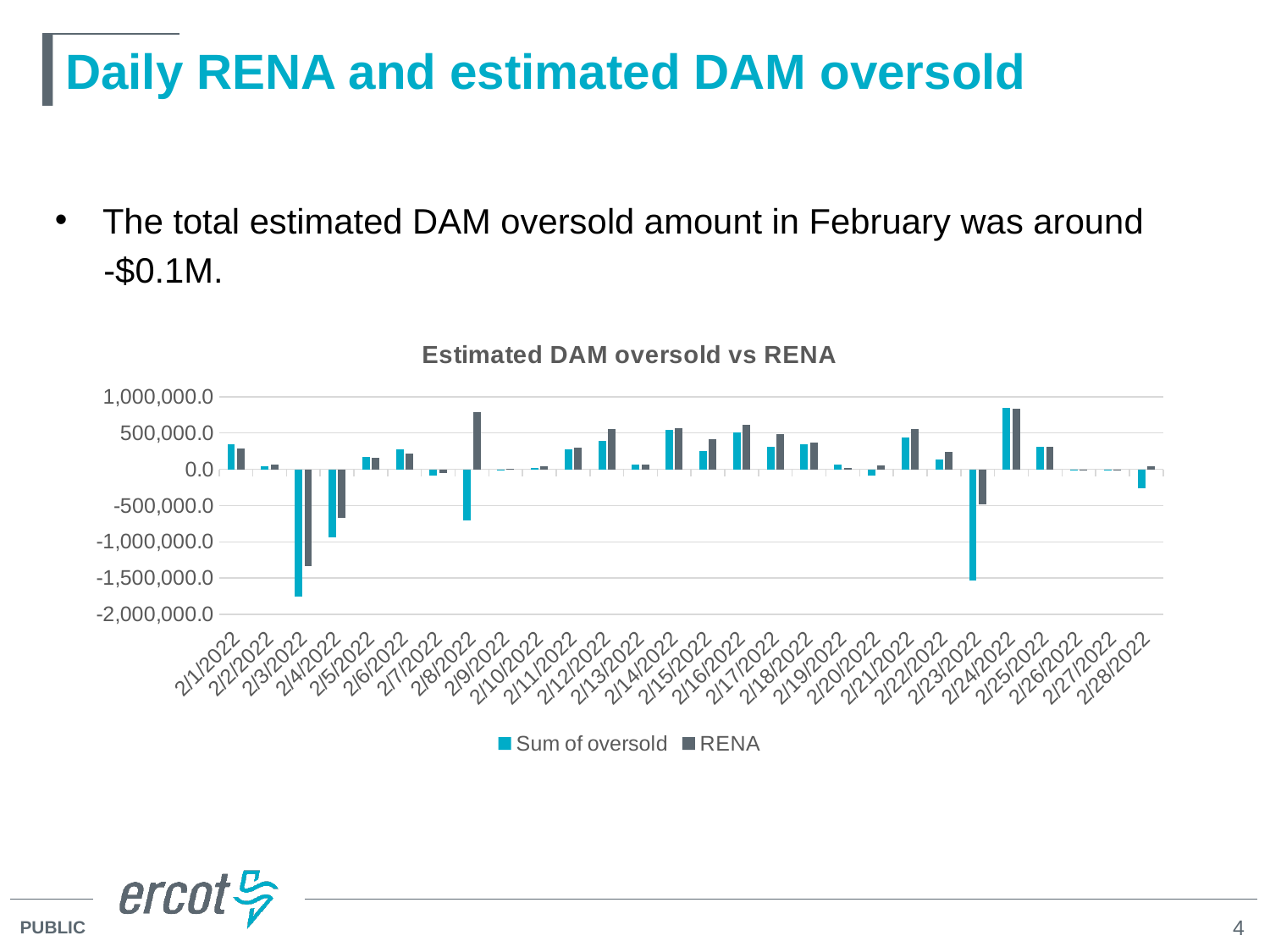
On 2/3/2022, which series has the larger value, Sum of oversold or RENA? RENA Is the RENA value for 2/8/2022 greater or less than 500,000.0? greater What are the two series named in the chart legend? Sum of oversold and RENA How many dates are shown on the x axis of the chart? 28 On which date is the Sum of oversold value the lowest? 2/3/2022 On which date is the Sum of oversold value the highest? 2/24/2022 Is the Sum of oversold value for 2/4/2022 greater or less than -500,000.0? less On which date is the RENA value the lowest? 2/3/2022 What is the title of the chart? Estimated DAM oversold vs RENA How many series does the chart legend list? 2 Is the Sum of oversold value for 2/3/2022 greater or less than -1,500,000.0? less What kind of chart is shown on the slide? Bar chart